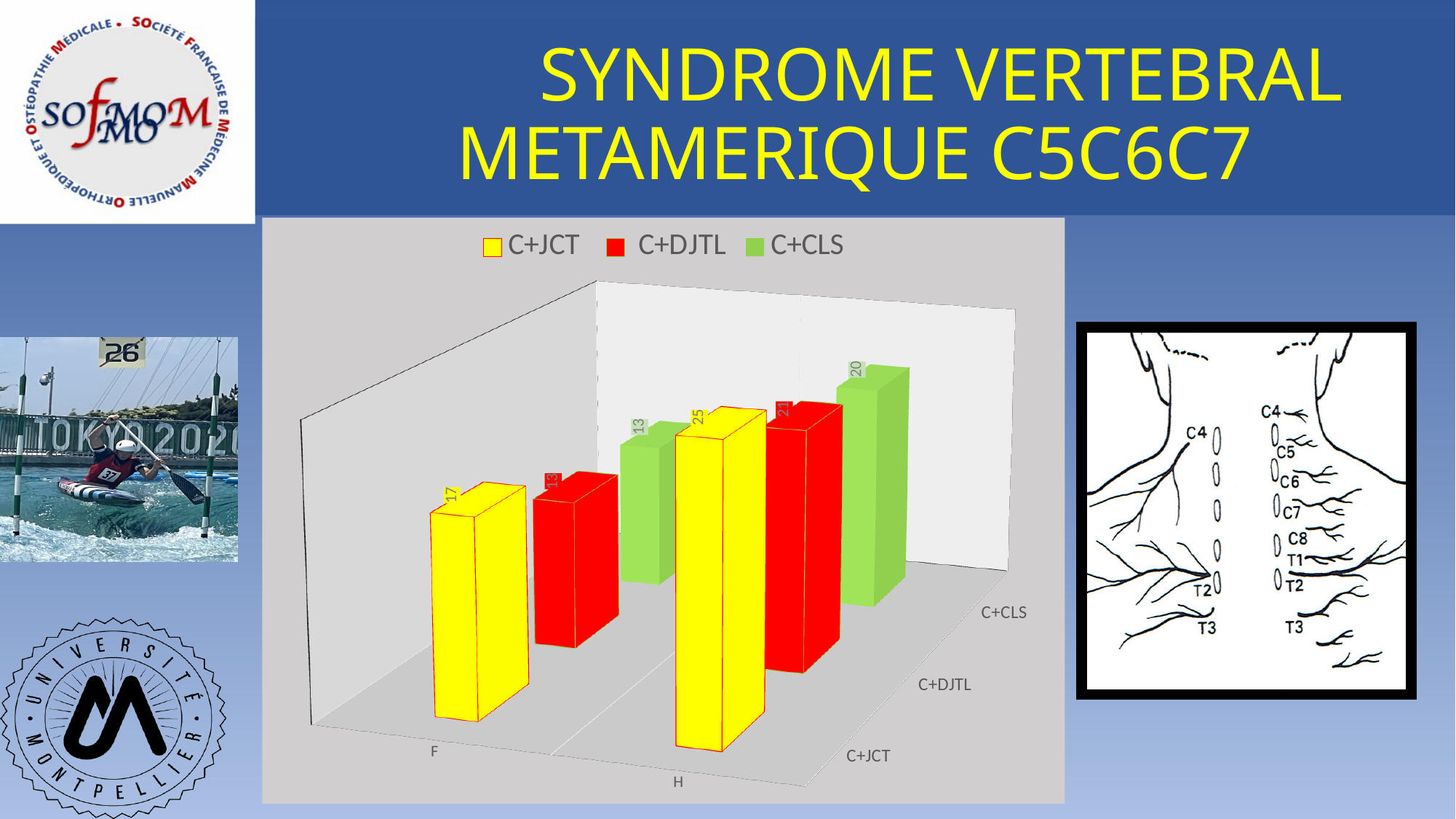
What is the difference between the C+JCT values for H and F? 8 How many series does the legend list? 3 What is the value of C+CLS for category F? 13 Which category has the lowest value for the C+JCT series? F Which series has the highest value for category H? C+JCT What kind of chart is shown on the slide? bar chart Which is larger, C+JCT for F or C+DJTL for F? C+JCT for F What colour represents the C+CLS series in the chart? green What is the value of C+DJTL for category H? 21 What is the difference between C+DJTL and C+CLS for category H? 1 What is the value of C+CLS for category H? 20 What is the value of C+JCT for category F? 17